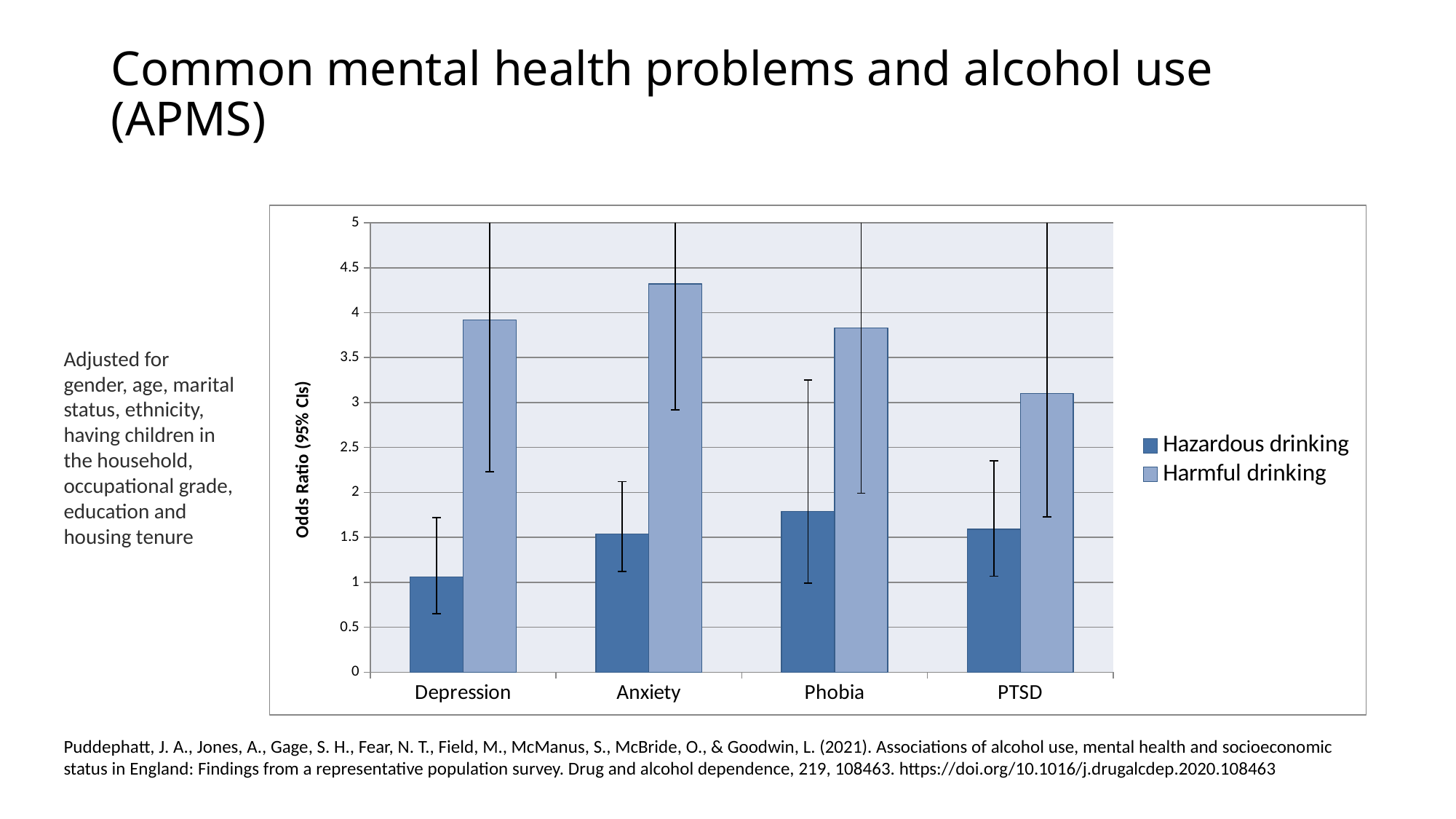
Which category has the lowest odds ratio for Hazardous drinking? Depression Which category has the lowest odds ratio for Harmful drinking? PTSD Is the Harmful drinking odds ratio for PTSD greater or less than 3.5? less Is the Hazardous drinking odds ratio for Depression greater or less than 1.5? less Which category has the highest odds ratio for Harmful drinking? Anxiety Is the Harmful drinking odds ratio for Anxiety greater or less than 4? greater What kind of chart is shown on the slide? bar chart How many mental health categories are shown on the x axis? 4 How many series does the legend list? 2 What is the label of the y axis? Odds Ratio (95% CIs) Which is larger: the Harmful drinking odds ratio for Depression or for Anxiety? Anxiety